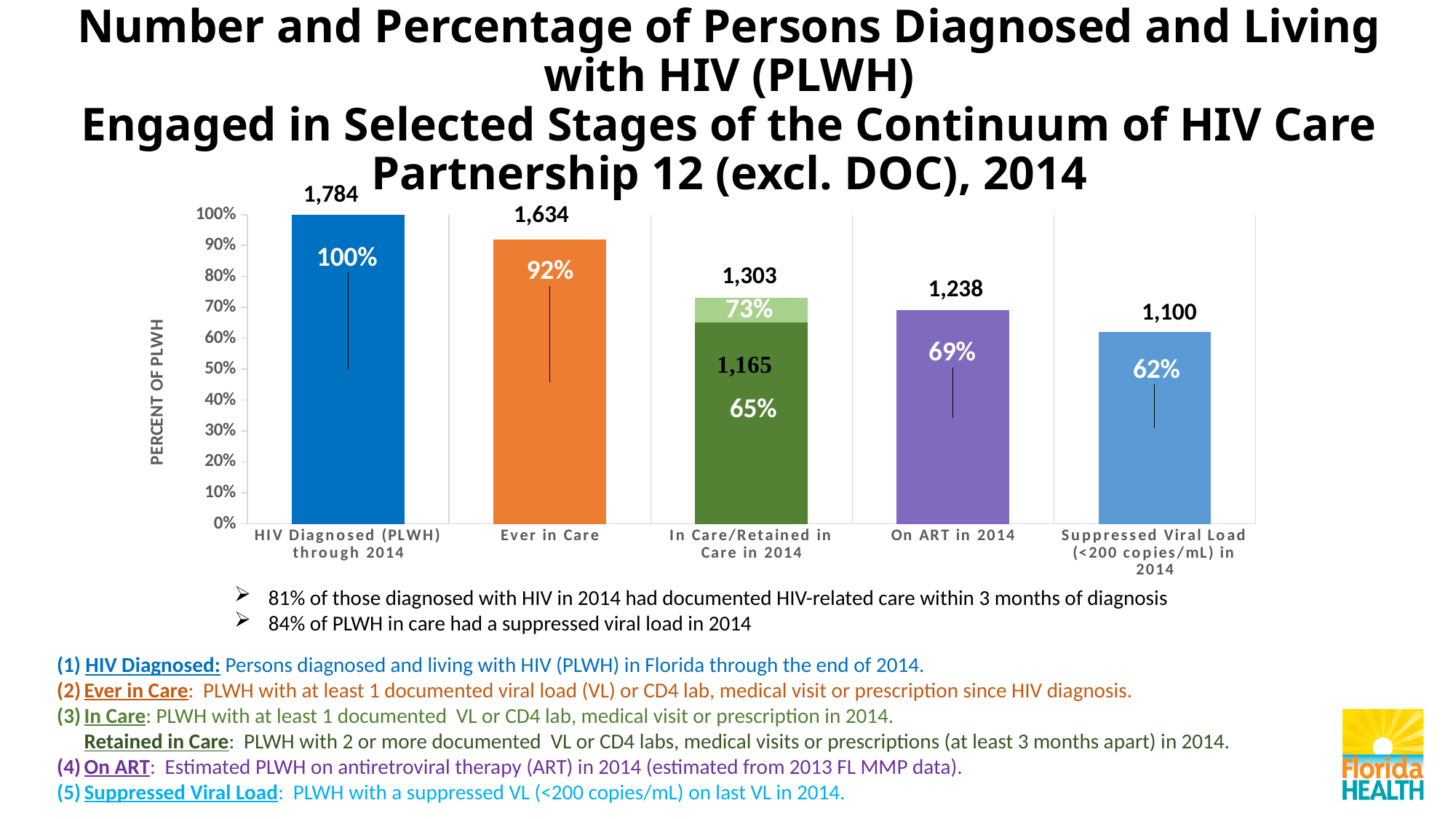
How many persons are shown for the On ART in 2014 bar? 1,238 What number is shown above the Suppressed Viral Load (<200 copies/mL) in 2014 bar? 1,100 Which category has the highest number of persons? HIV Diagnosed (PLWH) through 2014 Which is larger, the percentage for On ART in 2014 or the percentage for Suppressed Viral Load in 2014? On ART in 2014 What number is shown at the top of the In Care/Retained in Care in 2014 bar? 1,303 What is the label of the y axis? PERCENT OF PLWH What is the difference in number of persons between HIV Diagnosed (PLWH) through 2014 and Ever in Care? 150 What percentage is shown for the Retained in Care portion (darker green) of the In Care/Retained in Care in 2014 bar? 65% Which category has the lowest percentage of PLWH? Suppressed Viral Load (<200 copies/mL) in 2014 How many categories are shown on the x axis? 5 What percentage is shown for the Ever in Care bar? 92% What kind of chart is shown on the slide? Bar chart